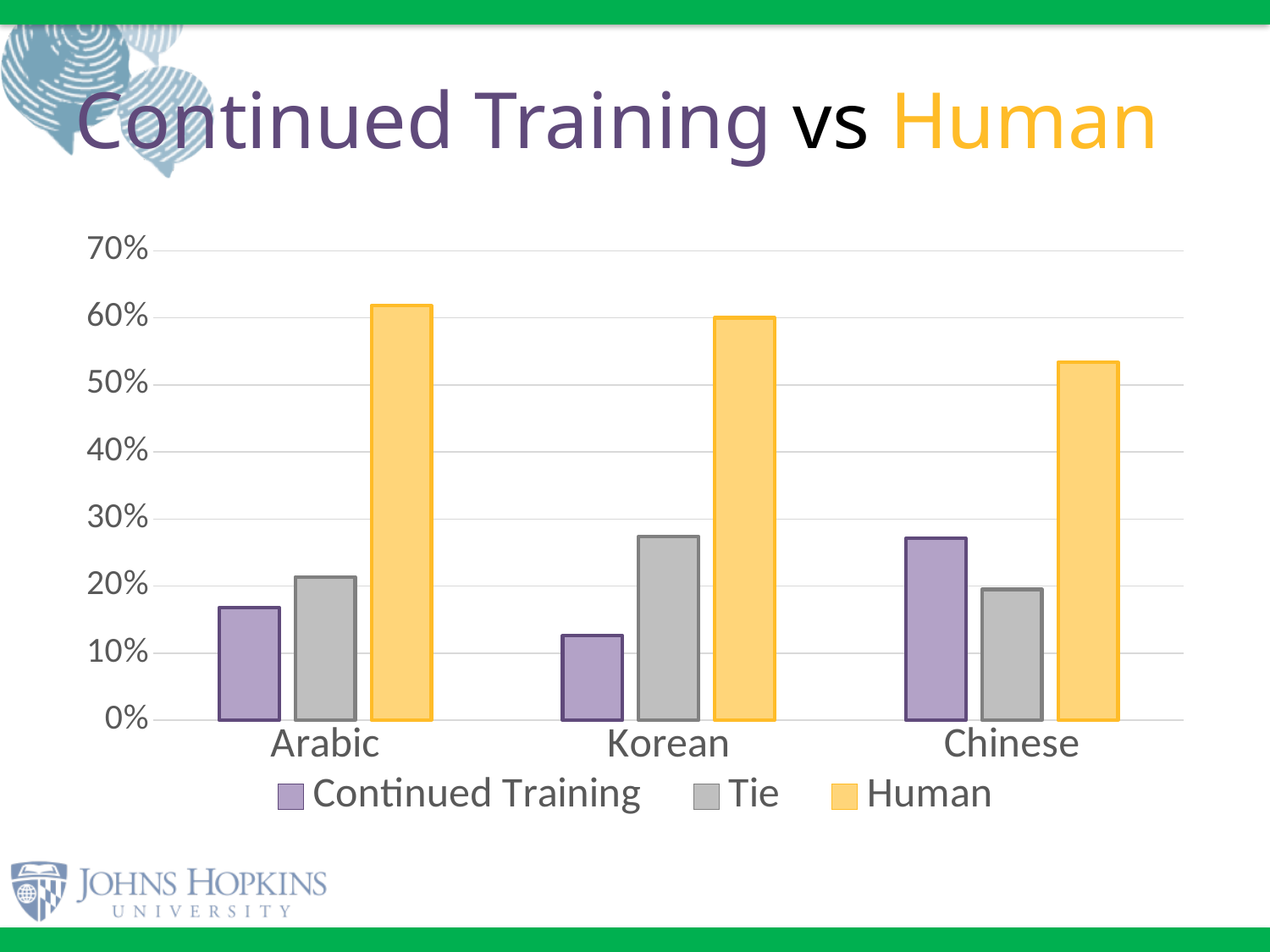
How many language categories are shown on the x axis? 3 Is the Continued Training value for Korean greater or less than 20%? less What is the title of the slide? Continued Training vs Human For Chinese, which is larger: the Continued Training bar or the Tie bar? Continued Training For which language is the Continued Training bar the lowest? Korean For which language is the Continued Training bar the highest? Chinese Which series has the highest value for every language? Human What kind of chart is shown on the slide? bar chart For Korean, which is larger: the Continued Training bar or the Tie bar? Tie Is the Human value for Arabic greater or less than 60%? greater For which language is the Human bar the lowest? Chinese How many series does the legend list? 3